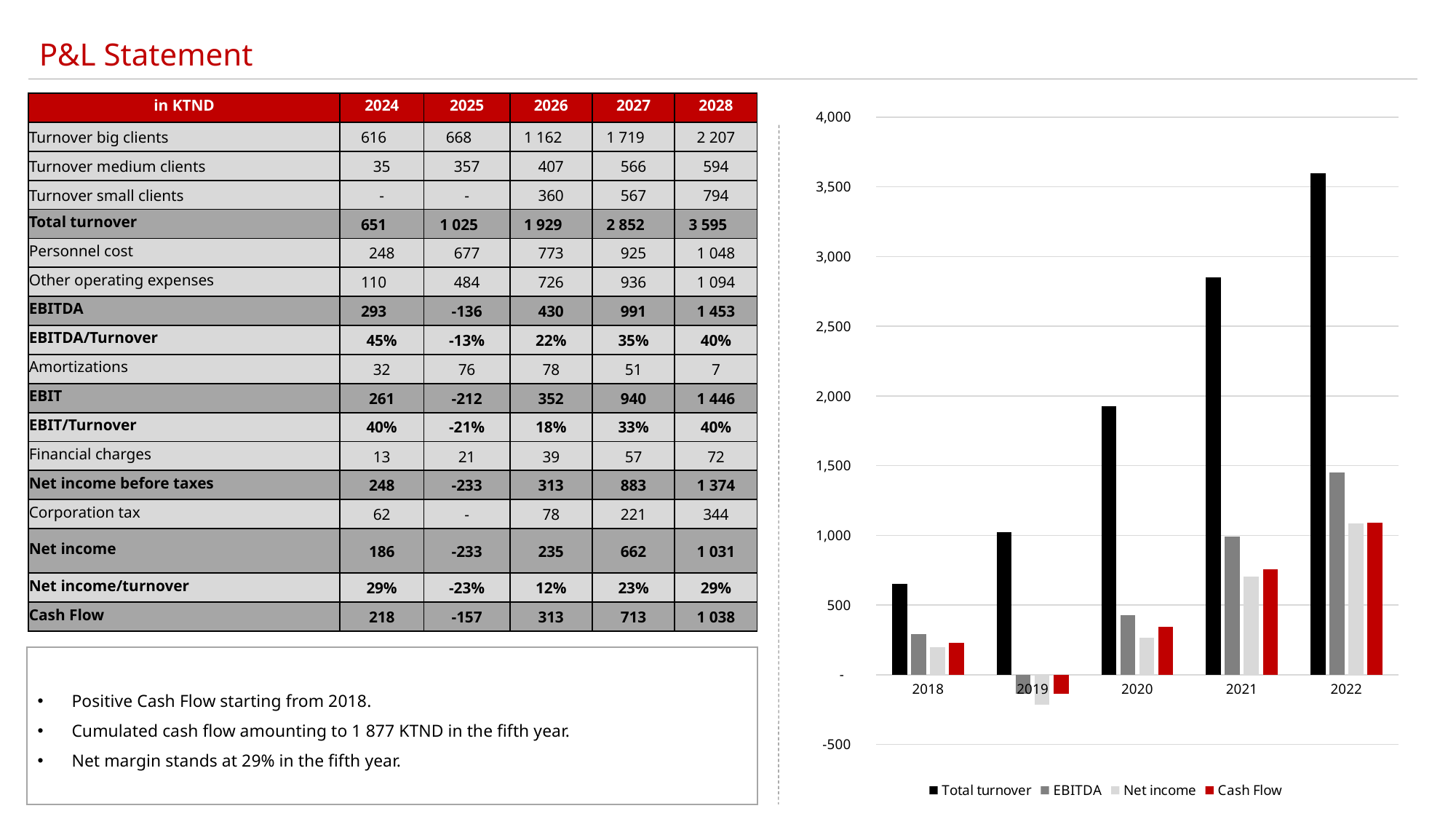
Is the Cash Flow value for 2018 greater or less than 500? less In which year is Total turnover highest in the chart? 2022 How many series does the chart legend list? 4 Does Total turnover rise or fall from 2018 to 2022? rise Which is larger in 2021: EBITDA or Cash Flow? EBITDA Is the Total turnover value for 2022 greater or less than 3,000? greater Is the EBITDA value for 2019 greater or less than 0? less How many years are shown on the x axis of the chart? 5 In which year is Total turnover lowest in the chart? 2018 Which series is shown in red in the chart? Cash Flow What kind of chart is shown on the right side of the slide? bar chart